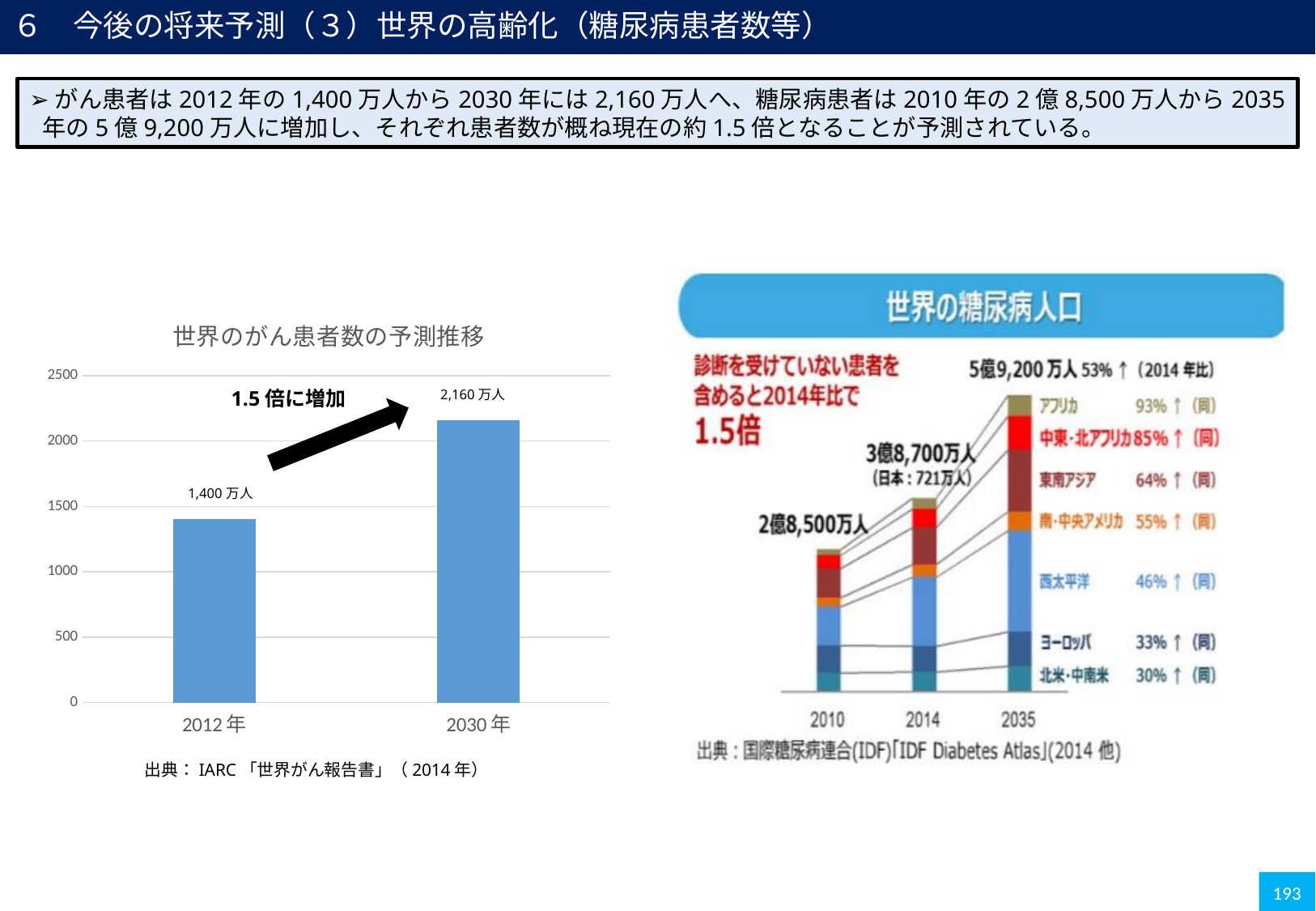
In the chart titled 世界のがん患者数の予測推移, what is the value for 2012年? 1,400万人 In the chart titled 世界の糖尿病人口, what is the total for 2010? 2億8,500万人 In the chart titled 世界のがん患者数の予測推移, what increase factor is written next to the arrow? 1.5倍に増加 In the chart titled 世界のがん患者数の予測推移, what is the value for 2030年? 2,160万人 In the chart titled 世界の糖尿病人口, what is the total for 2035? 5億9,200万人 In the chart titled 世界のがん患者数の予測推移, which year has the higher value, 2012年 or 2030年? 2030年 In the chart titled 世界のがん患者数の予測推移, how many categories are shown on the x axis? 2 In the chart titled 世界の糖尿病人口, what percentage increase is shown for アフリカ? 93% In the chart titled 世界の糖尿病人口, which year has the highest total, 2010, 2014 or 2035? 2035 In the chart titled 世界のがん患者数の予測推移, what is the difference between the 2030年 and 2012年 values? 760万人 In the chart titled 世界のがん患者数の予測推移, do the values rise or fall from 2012年 to 2030年? Rise What kind of chart is 世界のがん患者数の予測推移? Bar chart